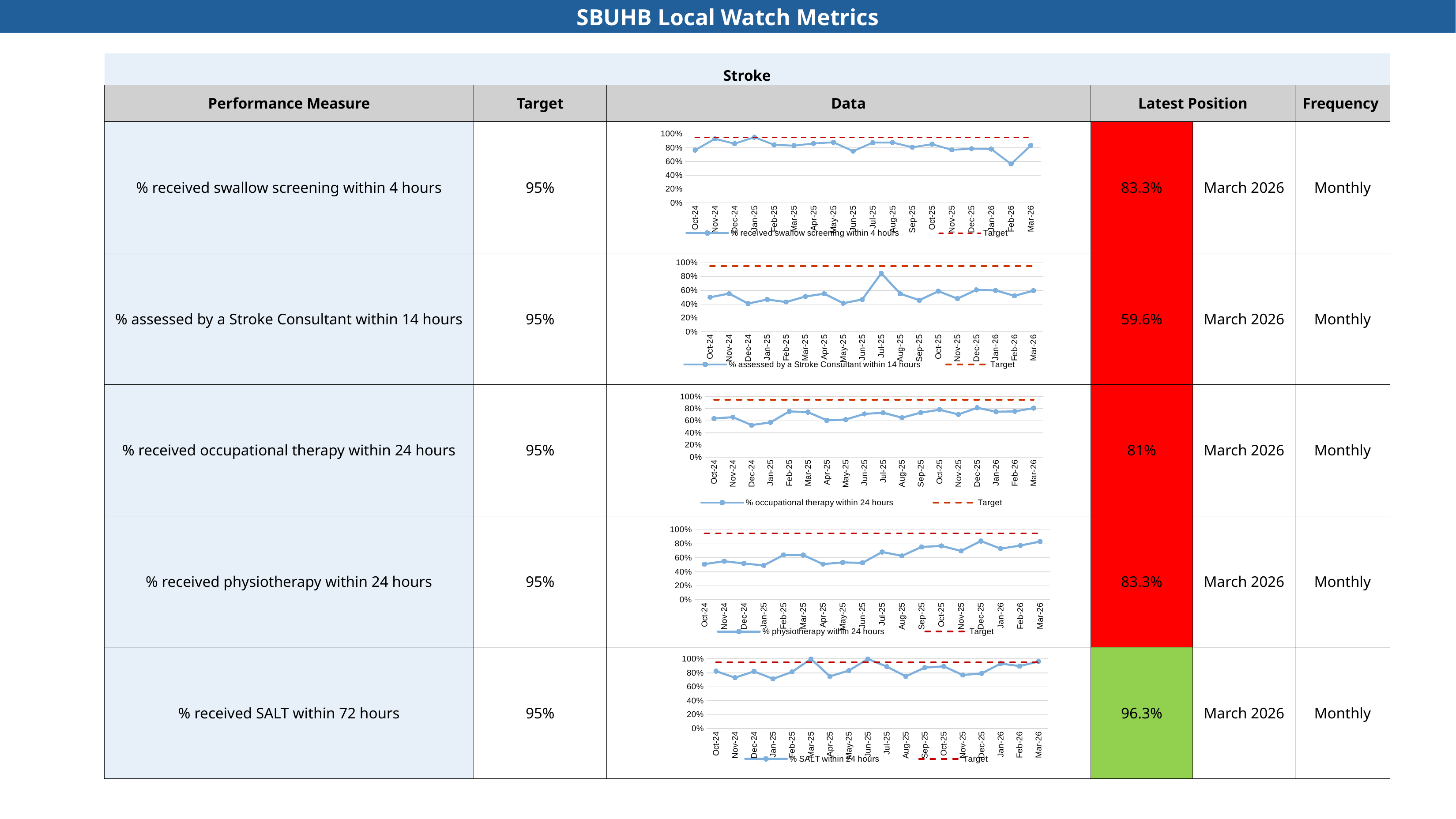
In the '% received swallow screening within 4 hours' chart, how many monthly points are plotted along the x axis? 18 What does the red dashed line in each chart represent? Target In the '% assessed by a Stroke Consultant within 14 hours' chart, which is larger, the value for Jul-25 or the value for Dec-24? Jul-25 How many series does the legend of the '% assessed by a Stroke Consultant within 14 hours' chart list? 2 In the '% received physiotherapy within 24 hours' chart, do the values generally rise or fall from Oct-24 to Mar-26? rise What kind of chart is used in the Data column for '% received swallow screening within 4 hours'? line chart In the '% assessed by a Stroke Consultant within 14 hours' chart, is the value for Dec-24 greater or less than 60%? less In the '% received SALT within 72 hours' chart, is the value for Mar-25 greater or less than 80%? greater In the '% received swallow screening within 4 hours' chart, which month has the lowest value? Feb-26 In the '% received swallow screening within 4 hours' chart, is the value for Feb-26 greater or less than 80%? less In the '% assessed by a Stroke Consultant within 14 hours' chart, which month has the highest value? Jul-25 In the '% received occupational therapy within 24 hours' chart, which month has the lowest value? Dec-24